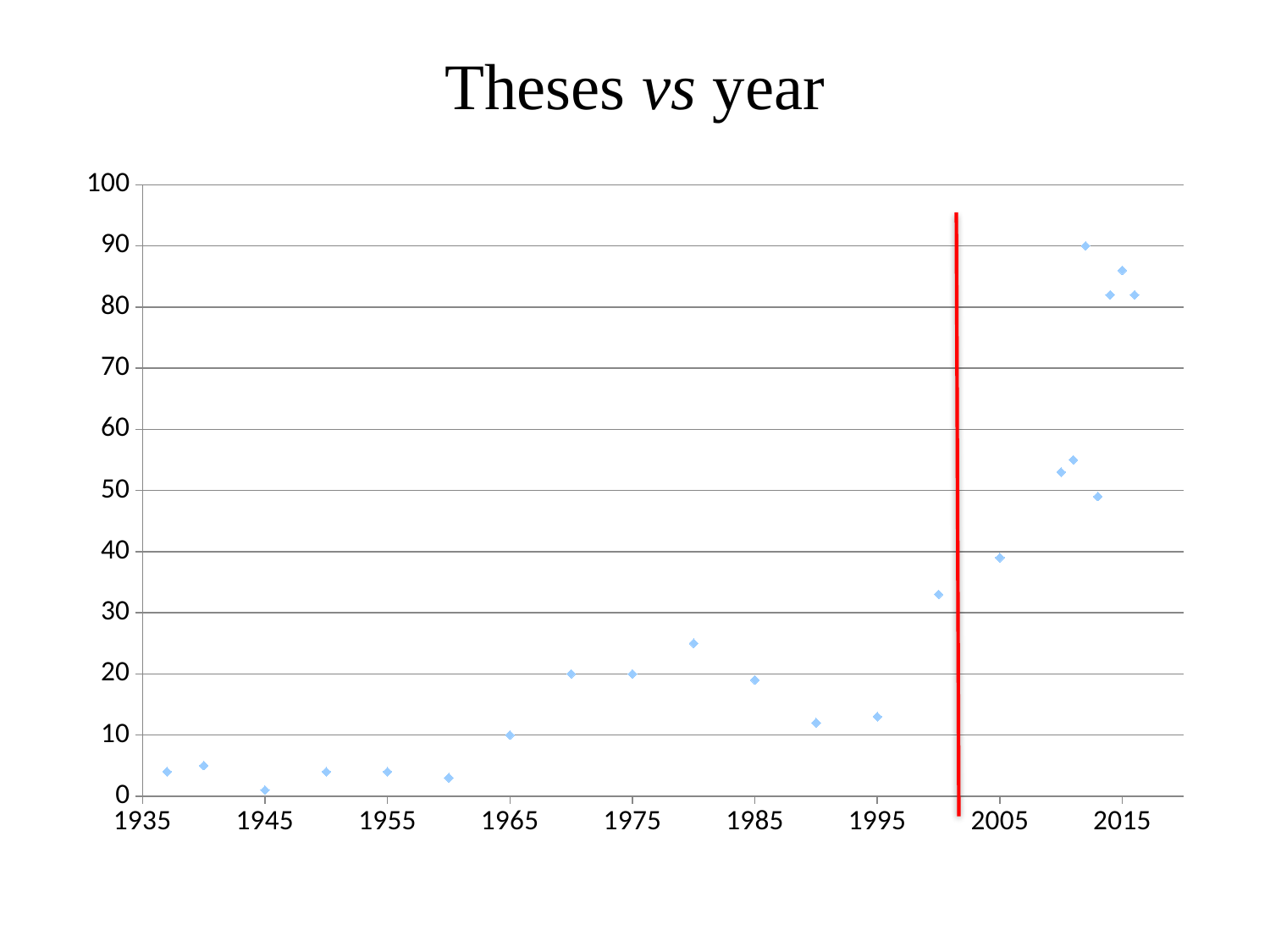
Do the plotted values generally rise or fall from 1935 to 2015? rise What is the value plotted for 1970? 20 Is the value for 2000 greater or less than 30? greater Is the value for 1980 greater or less than 20? greater Is the value for 1940 greater or less than 10? less What is the title of the chart? Theses vs year What is the value plotted for 1965? 10 Which year has the lowest plotted value? 1945 What is the value plotted for 1975? 20 Which is larger, the value for 2005 or the value for 1995? 2005 What kind of chart is shown on the slide? scatter chart